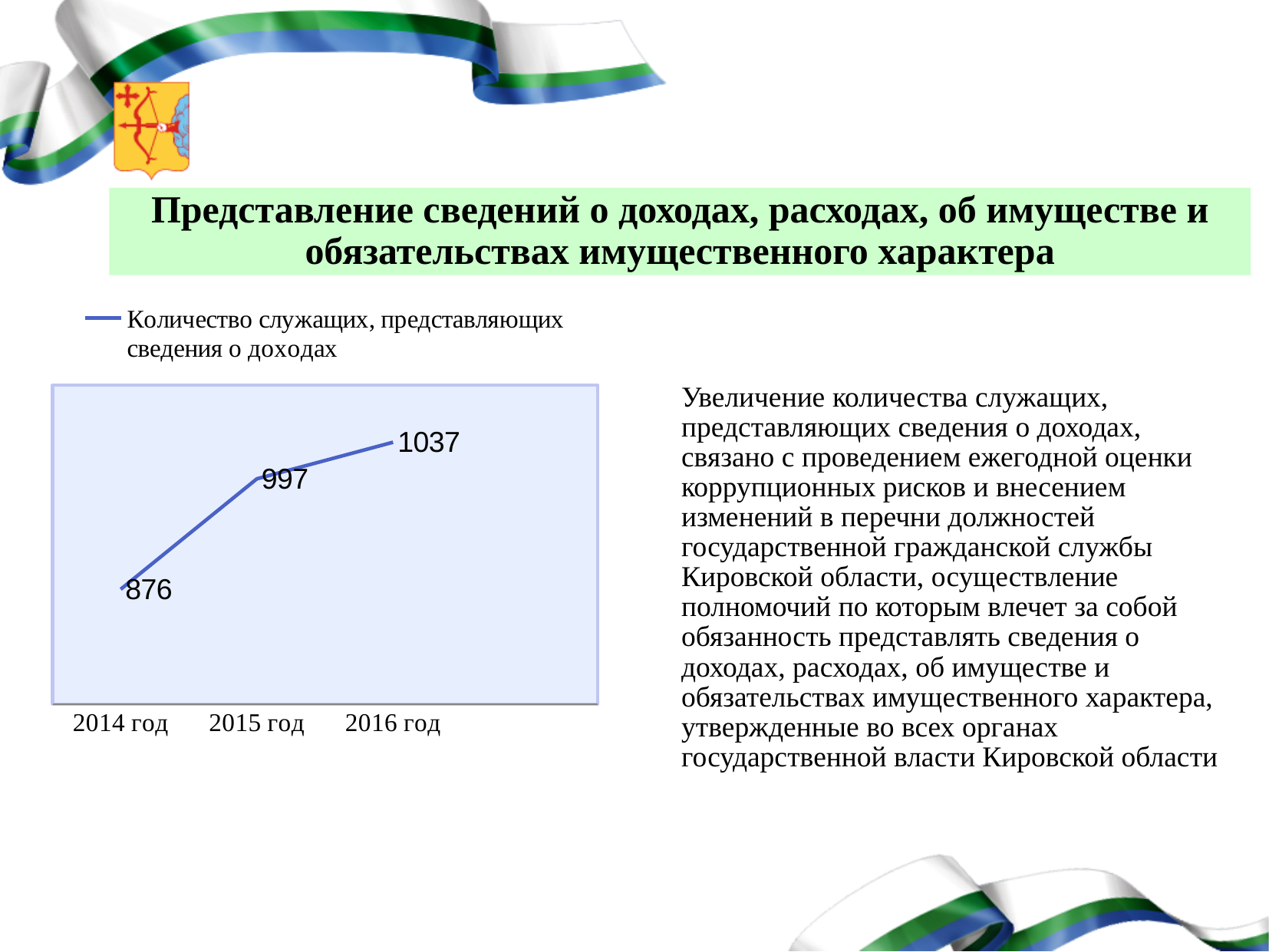
Which is larger, the value for 2015 год or the value for 2016 год? 2016 год What is the difference between the values for 2016 год and 2014 год? 161 What is the value for 2014 год? 876 Which year has the lowest value? 2014 год Do the values rise or fall from 2014 год to 2016 год? rise How many data points are plotted on the chart? 3 How many series does the legend list? 1 Which year has the highest value? 2016 год What kind of chart is shown on the slide? line chart What is the value for 2016 год? 1037 What is the difference between the values for 2015 год and 2014 год? 121 What is the value for 2015 год? 997